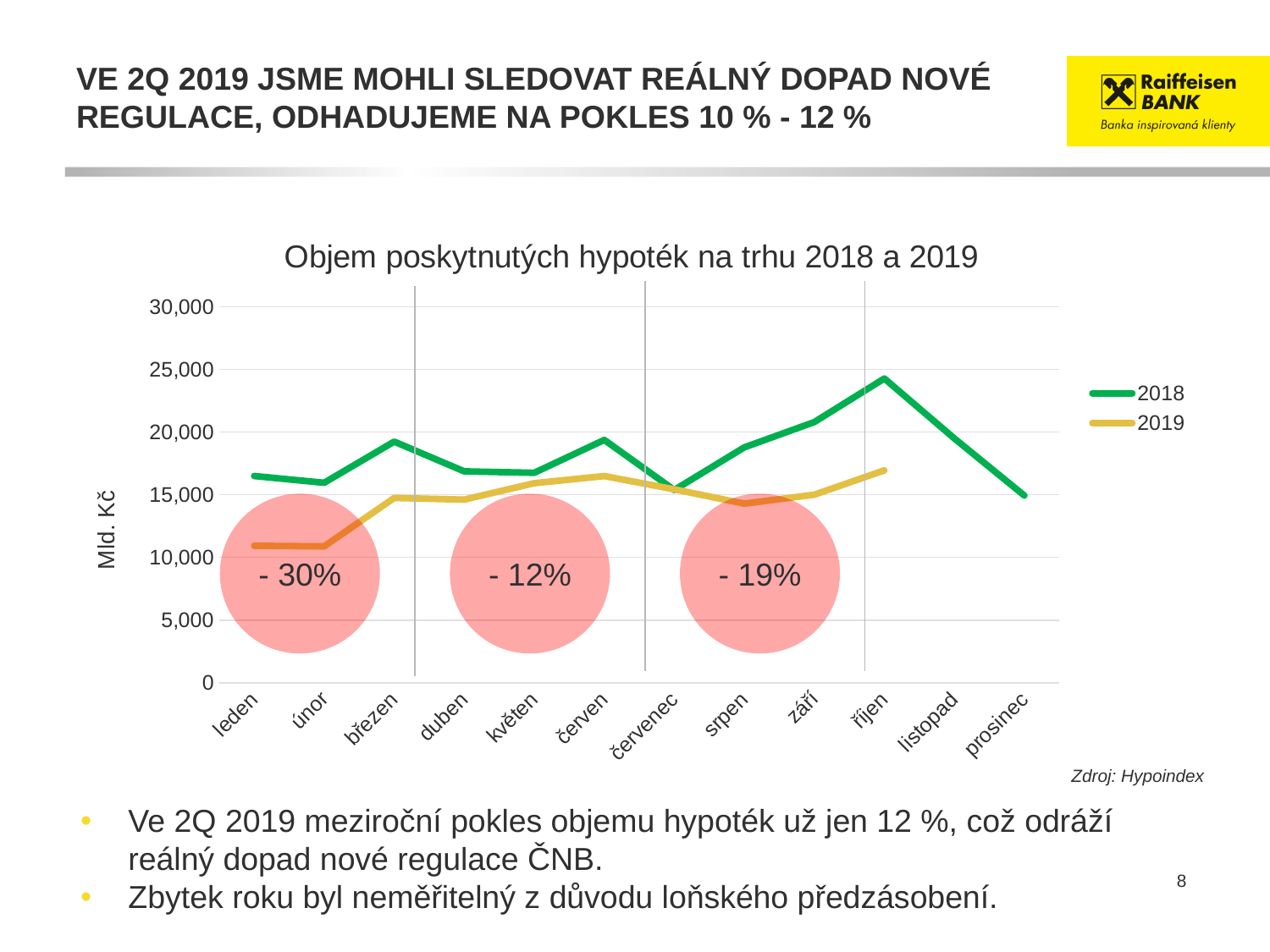
How many series does the legend list? 2 What is the title of the chart? Objem poskytnutých hypoték na trhu 2018 a 2019 Is the 2019 value for leden greater or less than 15,000? less In which month does the 2018 series reach its highest value? říjen What kind of chart is shown on the slide? line chart Which series has the larger value in leden, 2018 or 2019? 2018 How many months are shown on the x axis of the chart? 12 Is the 2019 value for červen greater or less than 15,000? greater Is the 2018 value for březen greater or less than 20,000? less What label is shown on the y axis of the chart? Mld. Kč Does the 2019 series rise or fall from leden to březen? rise